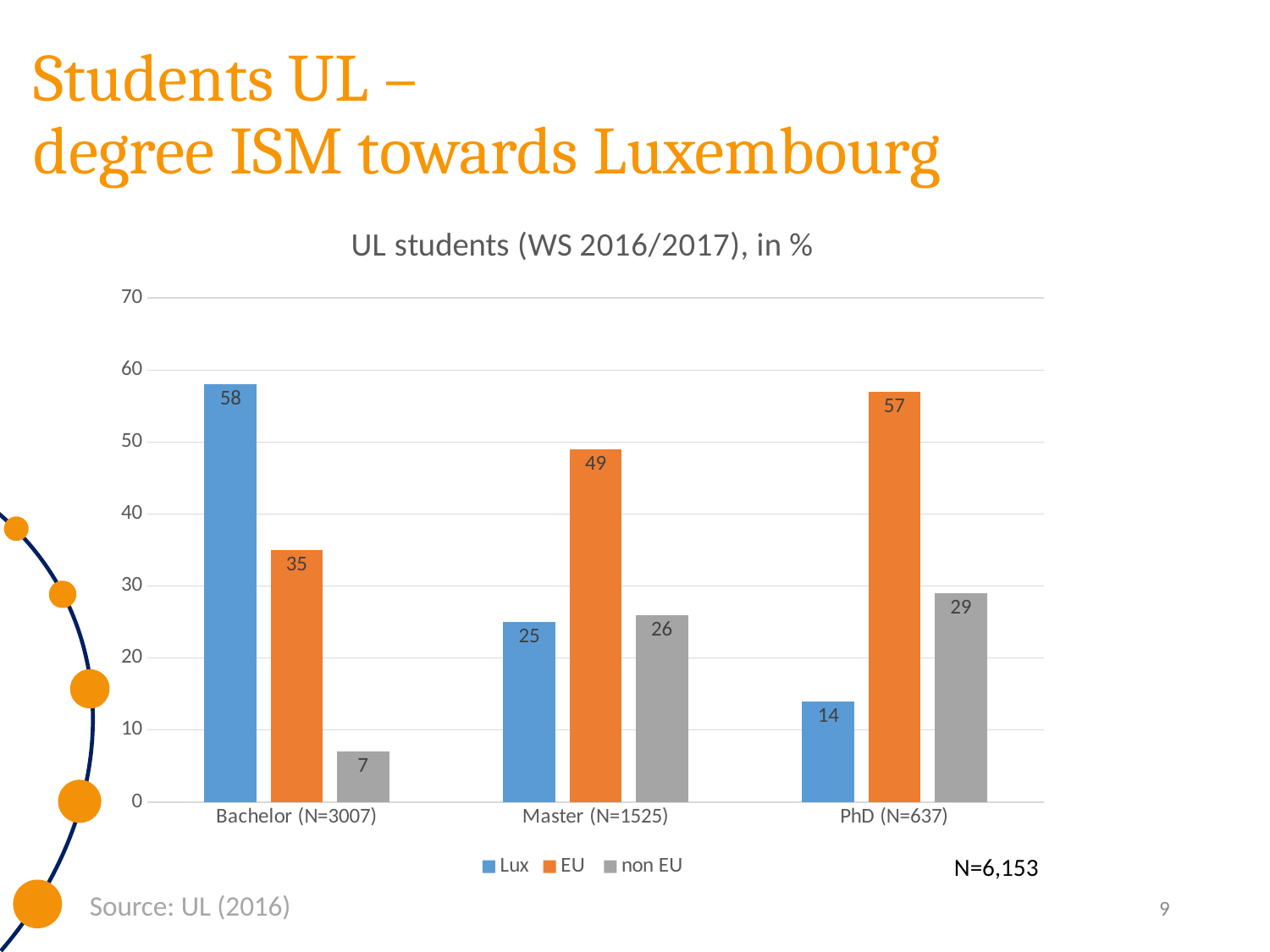
What is the value for Lux in the Bachelor (N=3007) category? 58 How many series does the legend list? 3 How many categories are shown on the x axis? 3 What kind of chart is shown on the slide? bar chart What is the difference between the Lux and EU values in the Bachelor (N=3007) category? 23 Which category has the lowest value for the non EU series? Bachelor (N=3007) What is the title of the chart? UL students (WS 2016/2017), in % Is the value for EU in the PhD (N=637) category greater or less than 50? greater Which category has the highest value for the EU series? PhD (N=637) Which is larger in the Master (N=1525) category: Lux or non EU? non EU What is the value for EU in the Master (N=1525) category? 49 What is the value for non EU in the PhD (N=637) category? 29